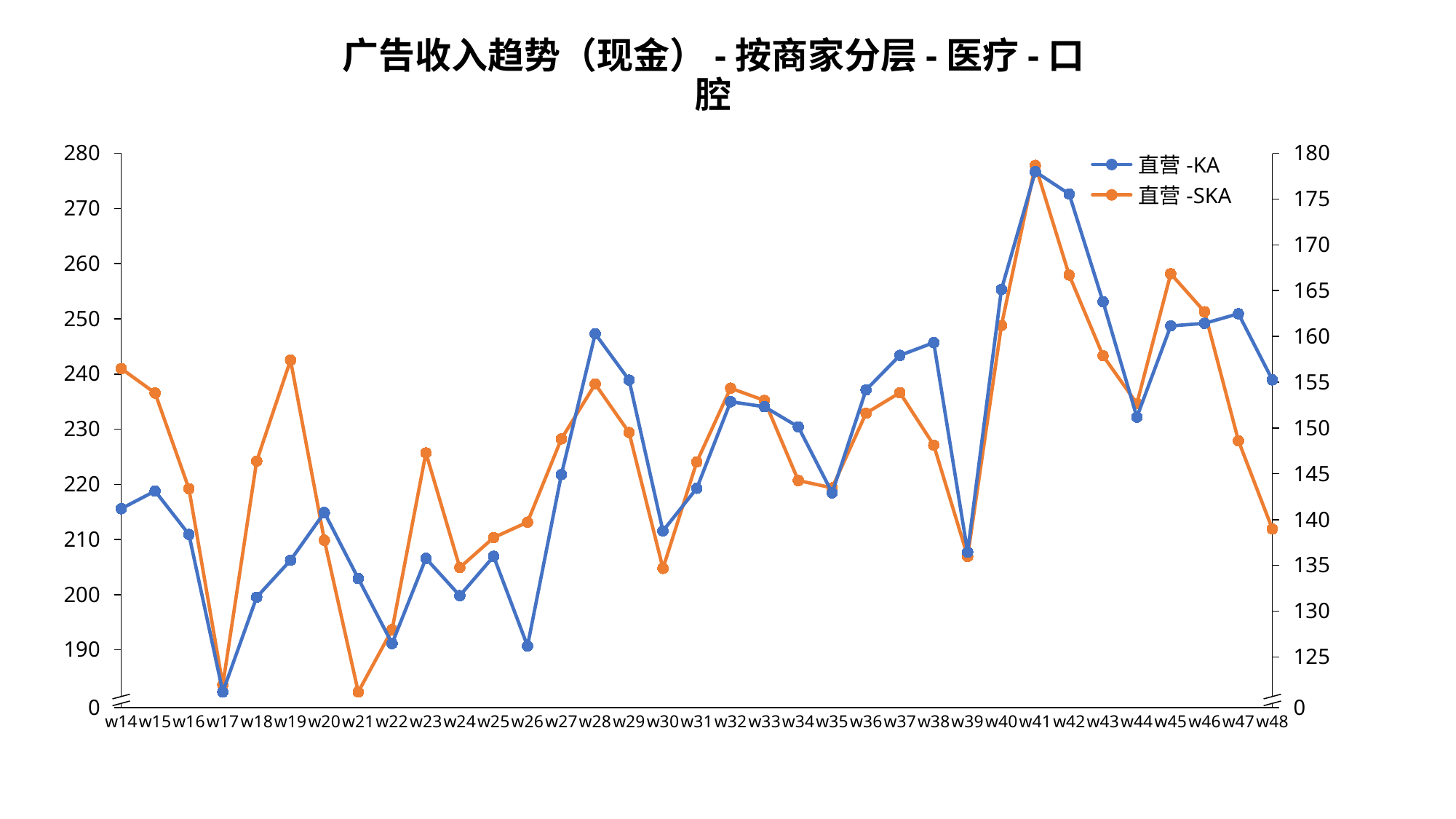
For the 直营-KA series, which is higher: w28 or w29? w28 Does the 直营-KA series rise or fall from w39 to w41? rise Is the value for 直营-KA at w26 greater or less than 200? less What kind of chart is shown on the slide? line chart In which week does the 直营-KA series reach its lowest value? w17 In which week does the 直营-KA series reach its highest value? w41 Is the value for 直营-KA at w28 greater or less than 240? greater How many series does the legend list? 2 In which week does the 直营-SKA series reach its highest value? w41 Is the value for 直营-SKA at w41 greater or less than 175? greater How many weeks are plotted along the x axis? 35